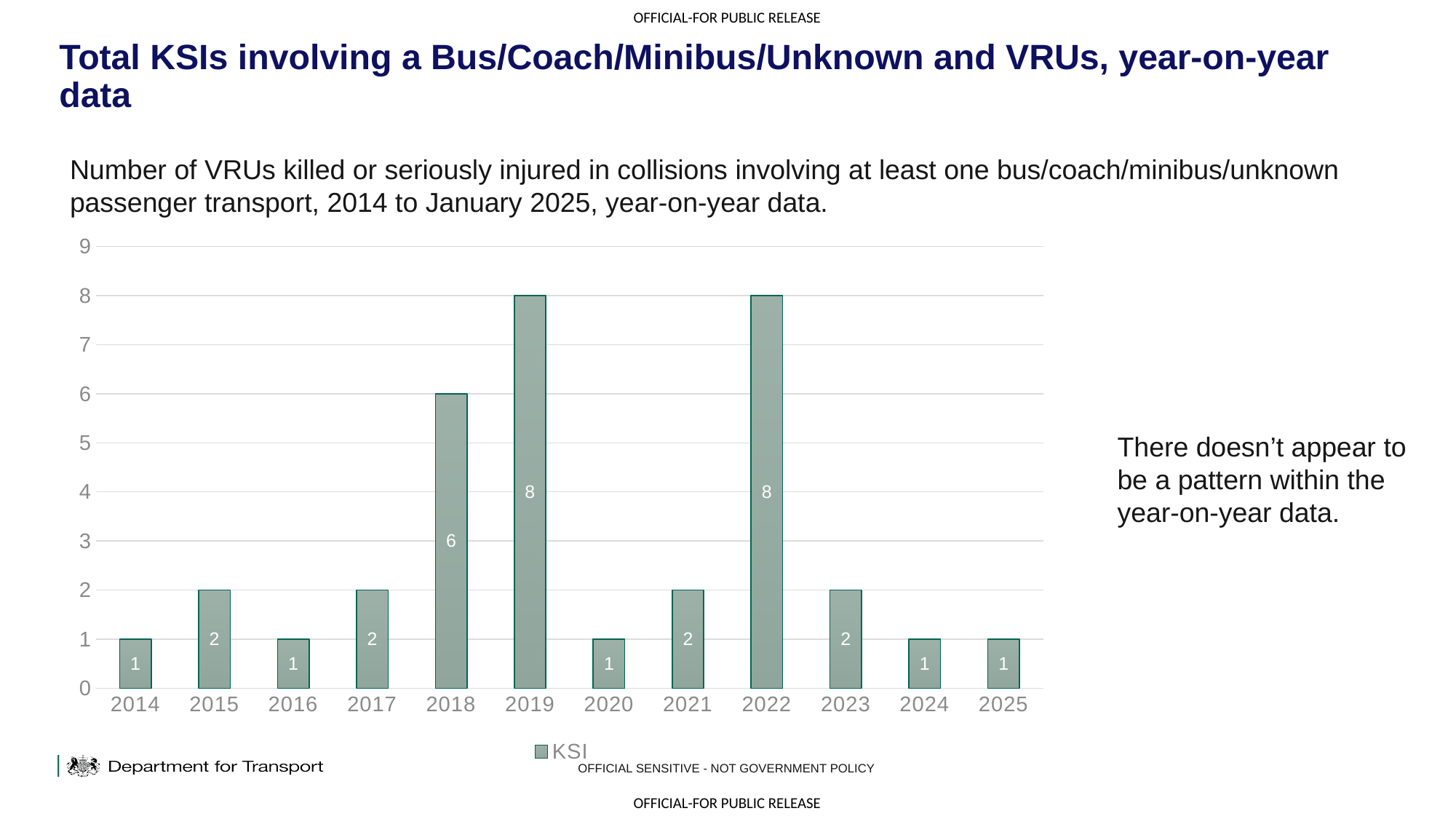
Which year has the larger KSI value, 2018 or 2021? 2018 What is the difference between the KSI values for 2019 and 2018? 2 What kind of chart is shown on the slide? Bar chart What is the KSI value for 2018? 6 Is the KSI value for 2019 greater or less than 5? greater How many series does the legend list? 1 What is the KSI value for 2014? 1 Which years have the highest KSI value? 2019 and 2022 How many years are shown on the x axis? 12 What is the KSI value for 2023? 2 What is the name of the series shown in the legend? KSI What is the KSI value for 2022? 8